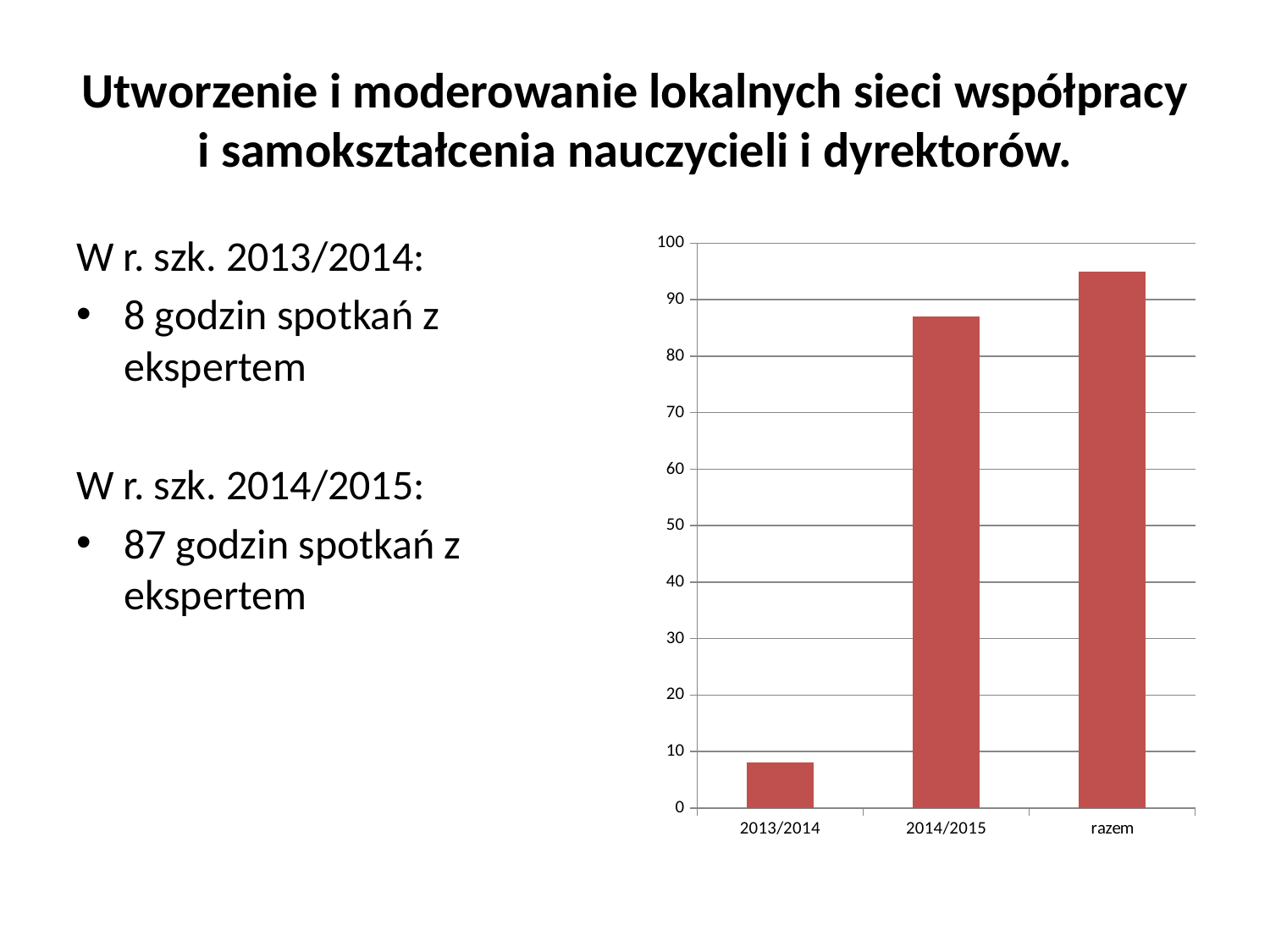
Which category has the lowest bar in the chart? 2013/2014 Which category has the highest bar in the chart? razem Is the value for razem greater or less than 90? greater Do the bar values rise or fall from left to right along the x axis? rise How many categories are shown on the x axis of the chart? 3 Is the value for 2013/2014 greater or less than 10? less Which is larger, the bar for 2014/2015 or the bar for 2013/2014? 2014/2015 According to the slide, how many hours of meetings with an expert were held in 2013/2014 (the value of the first bar)? 8 What kind of chart is shown on the slide? bar chart According to the slide, how many hours of meetings with an expert were held in 2014/2015 (the value of the second bar)? 87 Is the value for 2014/2015 greater or less than 80? greater What colour are the bars in the chart? red